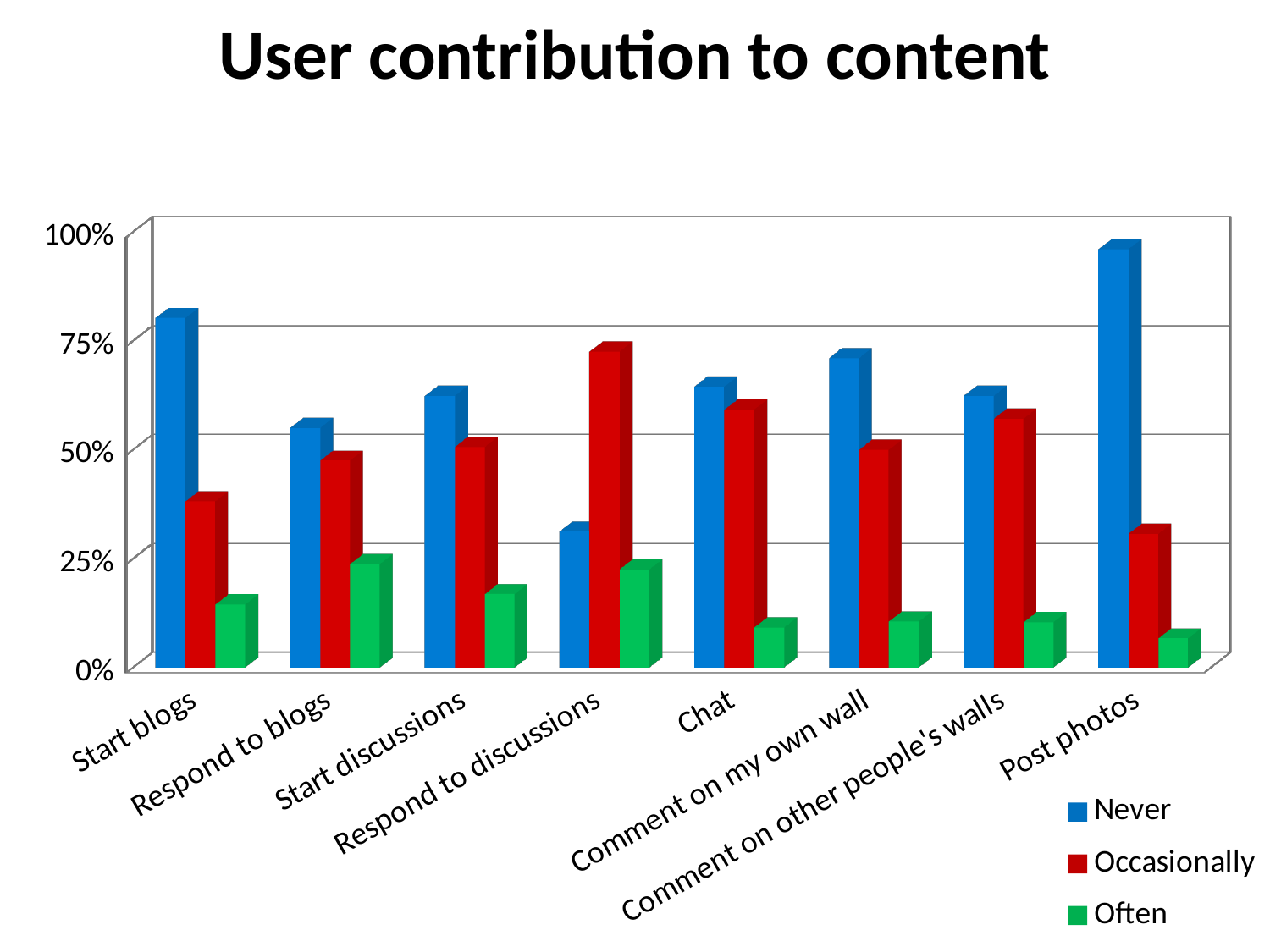
Which category has the highest value for the Occasionally series? Respond to discussions How many categories are shown on the x axis? 8 Is the Occasionally value for Start blogs greater or less than 50%? less How many series does the legend list? 3 What kind of chart is shown on the slide? bar chart Is the Often value for Chat greater or less than 25%? less For Respond to discussions, which is larger: the Never value or the Occasionally value? Occasionally Is the Never value for Post photos greater or less than 75%? greater Which category has the lowest value for the Never series? Respond to discussions For Start blogs, which is larger: the Never value or the Occasionally value? Never What is the title of the chart? User contribution to content Which category has the highest value for the Never series? Post photos